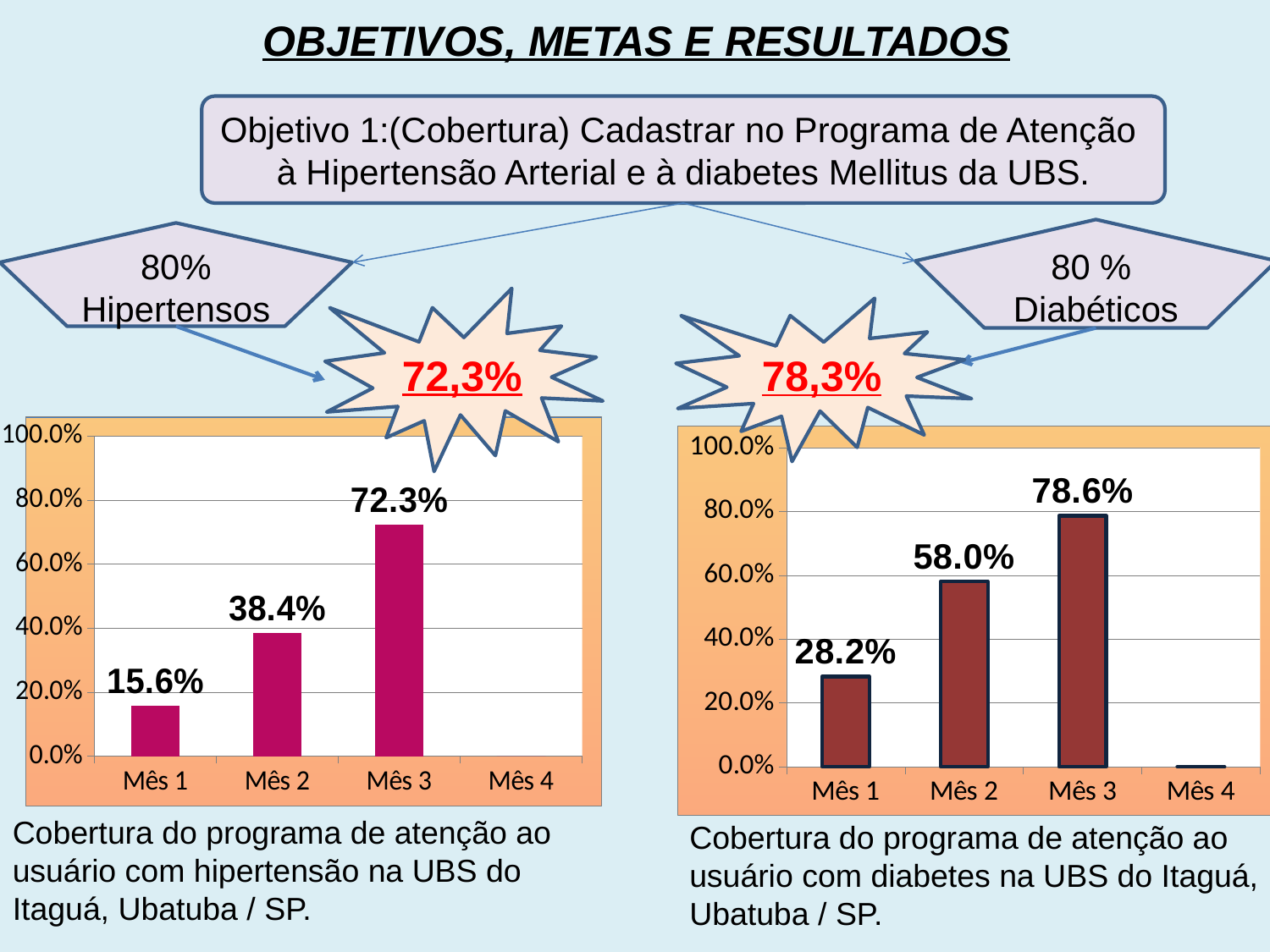
In the right chart (diabetes coverage), is the value for Mês 1 greater or less than 40.0%? less In the right chart (diabetes coverage), what is the value for Mês 3? 78.6% In the left chart (hypertension coverage), what is the difference between Mês 3 and Mês 2? 33.9% What type of chart is the right chart (diabetes coverage)? bar chart In the right chart (diabetes coverage), what is the difference between Mês 2 and Mês 1? 29.8% Which is larger: Mês 3 in the left chart (hypertension) or Mês 3 in the right chart (diabetes)? Mês 3 in the right chart (diabetes) In the left chart (hypertension coverage), do the values rise or fall from Mês 1 to Mês 3? rise In the right chart (diabetes coverage), which month has the highest value? Mês 3 In the left chart (hypertension coverage), what is the value for Mês 2? 38.4% What is the maximum value shown on the y axis of the right chart (diabetes coverage)? 100.0% How many month categories are shown on the x axis of the left chart (hypertension coverage)? 4 In the left chart (hypertension coverage), what is the value for Mês 1? 15.6%